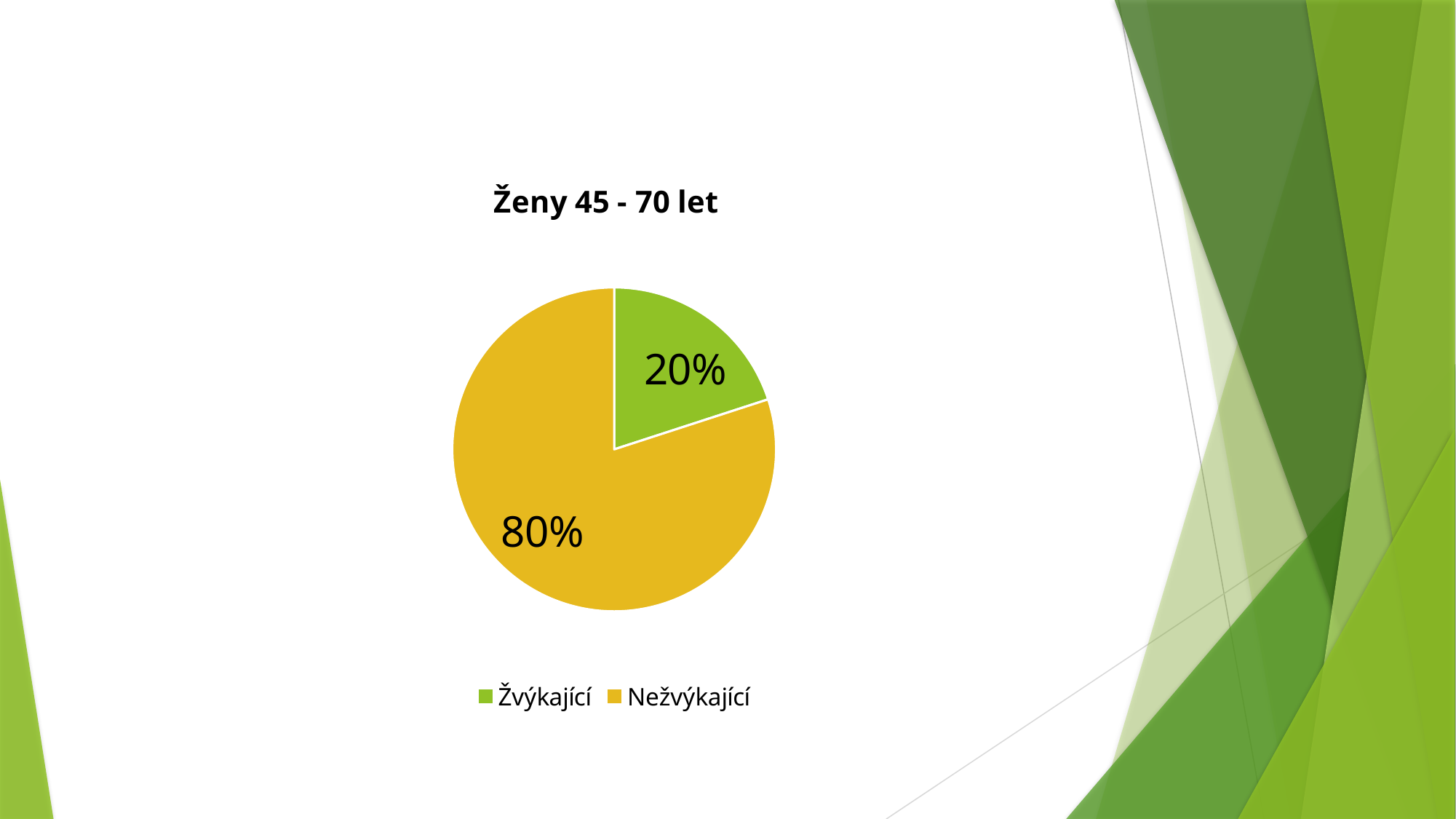
How many entries does the legend list? 2 What colour is the Žvýkající slice? green What kind of chart is shown on the slide? pie chart What is the title of the chart? Ženy 45 - 70 let Which category has the largest slice of the pie? Nežvýkající What share of the pie does Žvýkající represent? 20% What is the difference in percentage points between Nežvýkající and Žvýkající? 60 Which category has the smallest slice of the pie? Žvýkající Which is larger, the Žvýkající slice or the Nežvýkající slice? Nežvýkající What share of the pie does Nežvýkající represent? 80% How many slices does the pie chart have? 2